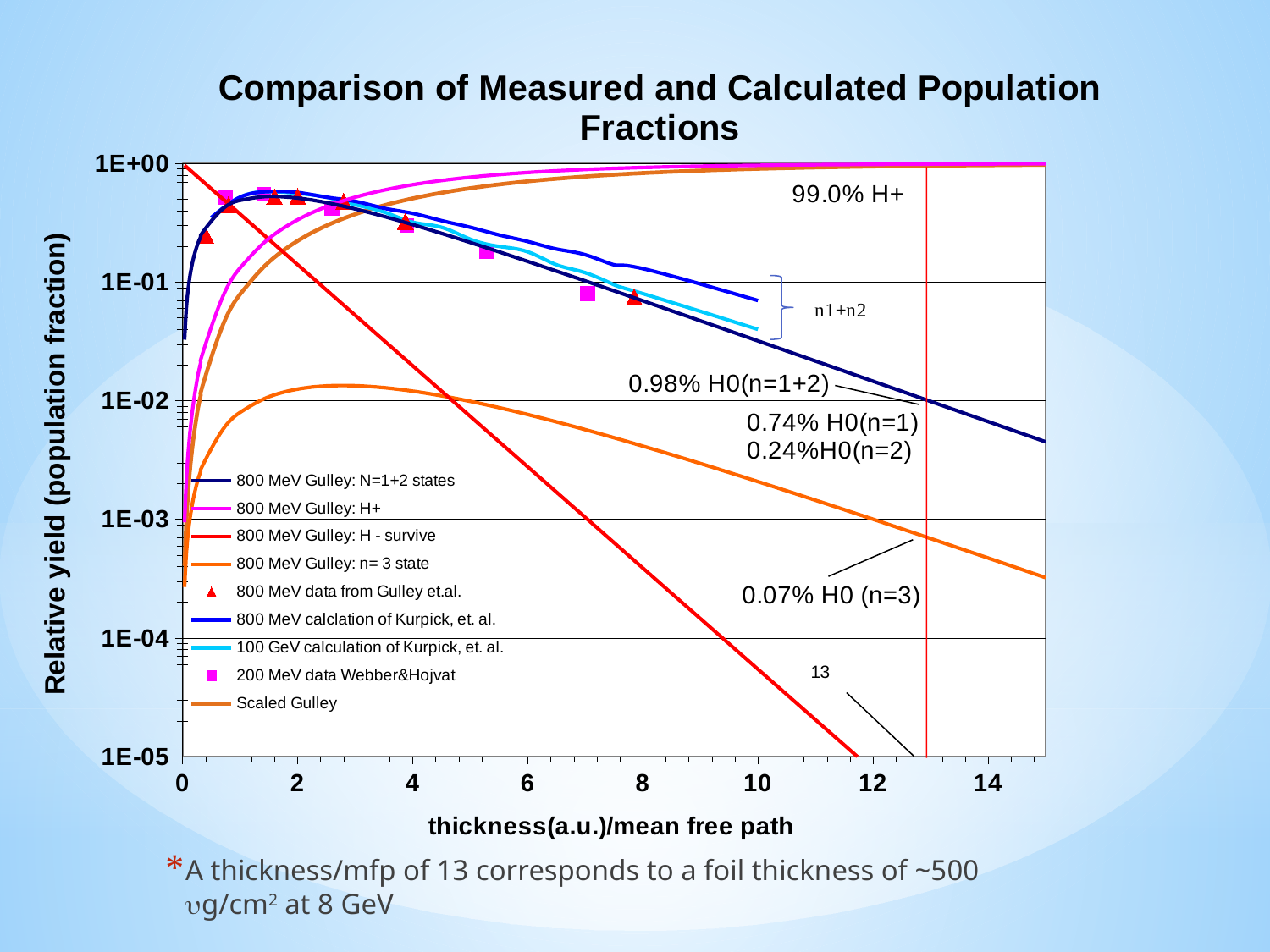
According to the annotation, what is the H0 (n=3) population fraction at a thickness/mfp of 13? 0.07% What kind of chart is shown on the slide? Line chart According to the annotation, what is the H0(n=1+2) population fraction at a thickness/mfp of 13? 0.98% At a thickness/mfp of 10, which series has the higher value: '800 MeV Gulley: H+' or '800 MeV Gulley: H - survive'? 800 MeV Gulley: H+ How many series does the legend list? 9 Does the '800 MeV Gulley: H - survive' series rise or fall as thickness/mean free path increases? Fall Is the value of the '800 MeV Gulley: H - survive' series at a thickness/mfp of 10 greater or less than 1E-03? less What is the label of the x axis? thickness(a.u.)/mean free path According to the annotation, what is the H0(n=1) population fraction at a thickness/mfp of 13? 0.74% According to the annotation, what percentage of H+ is reached at a thickness/mfp of 13? 99.0% What is the title of the chart? Comparison of Measured and Calculated Population Fractions Is the value of the '800 MeV Gulley: H+' series at a thickness/mfp of 8 greater or less than 1E-01? greater